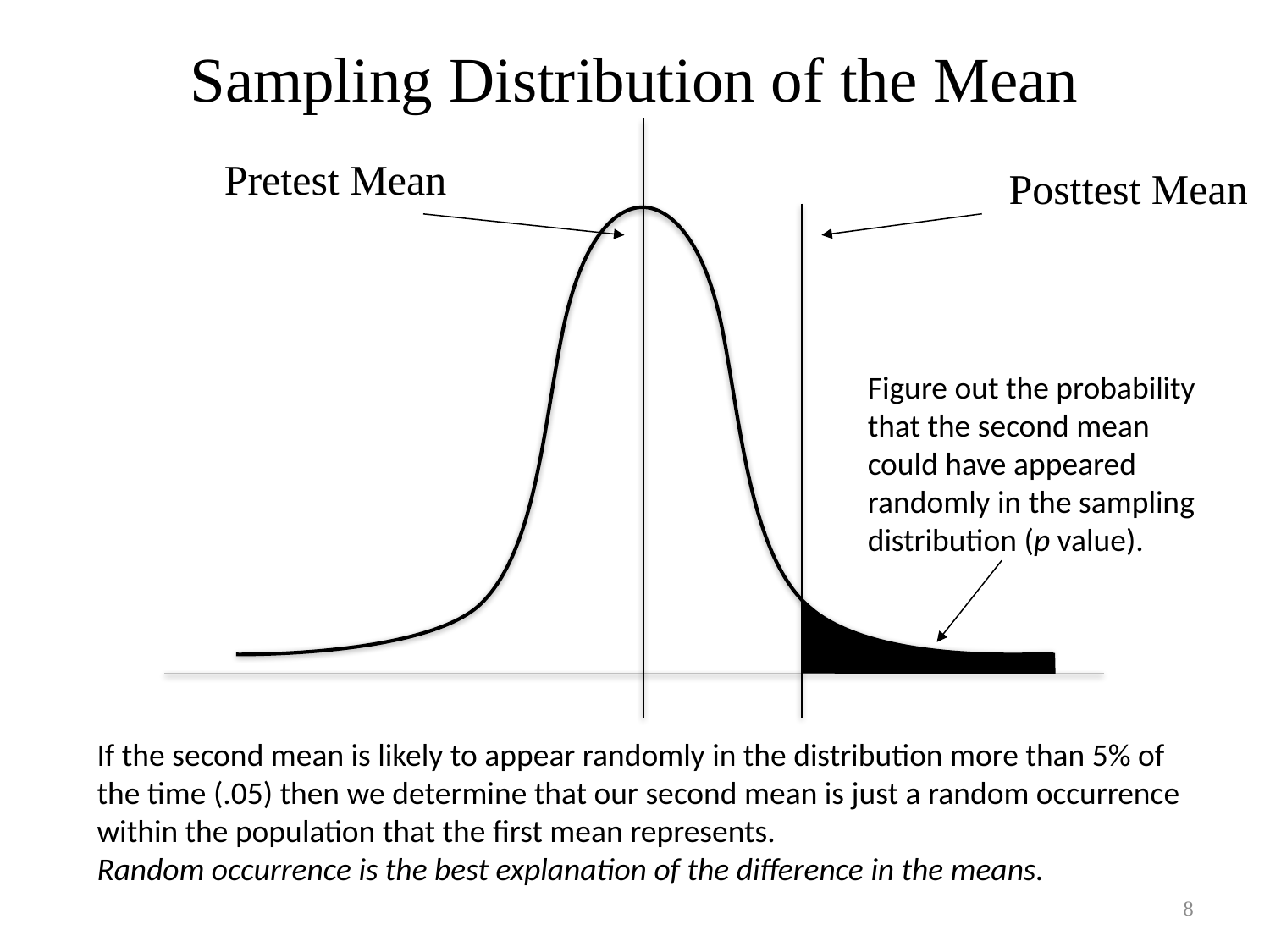
Which mean is located at the peak of the curve? Pretest Mean Does the curve rise or fall moving from the Pretest Mean line to the Posttest Mean line? Fall Which mean is marked further to the right on the curve, the Pretest Mean or the Posttest Mean? Posttest Mean What is the title of the chart on the slide? Sampling Distribution of the Mean What does the shaded area to the right of the Posttest Mean line represent, according to the slide? The probability that the second mean could have appeared randomly in the sampling distribution (p value) How many means are marked with vertical lines on the curve? 2 Which mean is located in the right tail of the curve? Posttest Mean What kind of chart is shown on the slide? A bell curve (normal distribution curve)